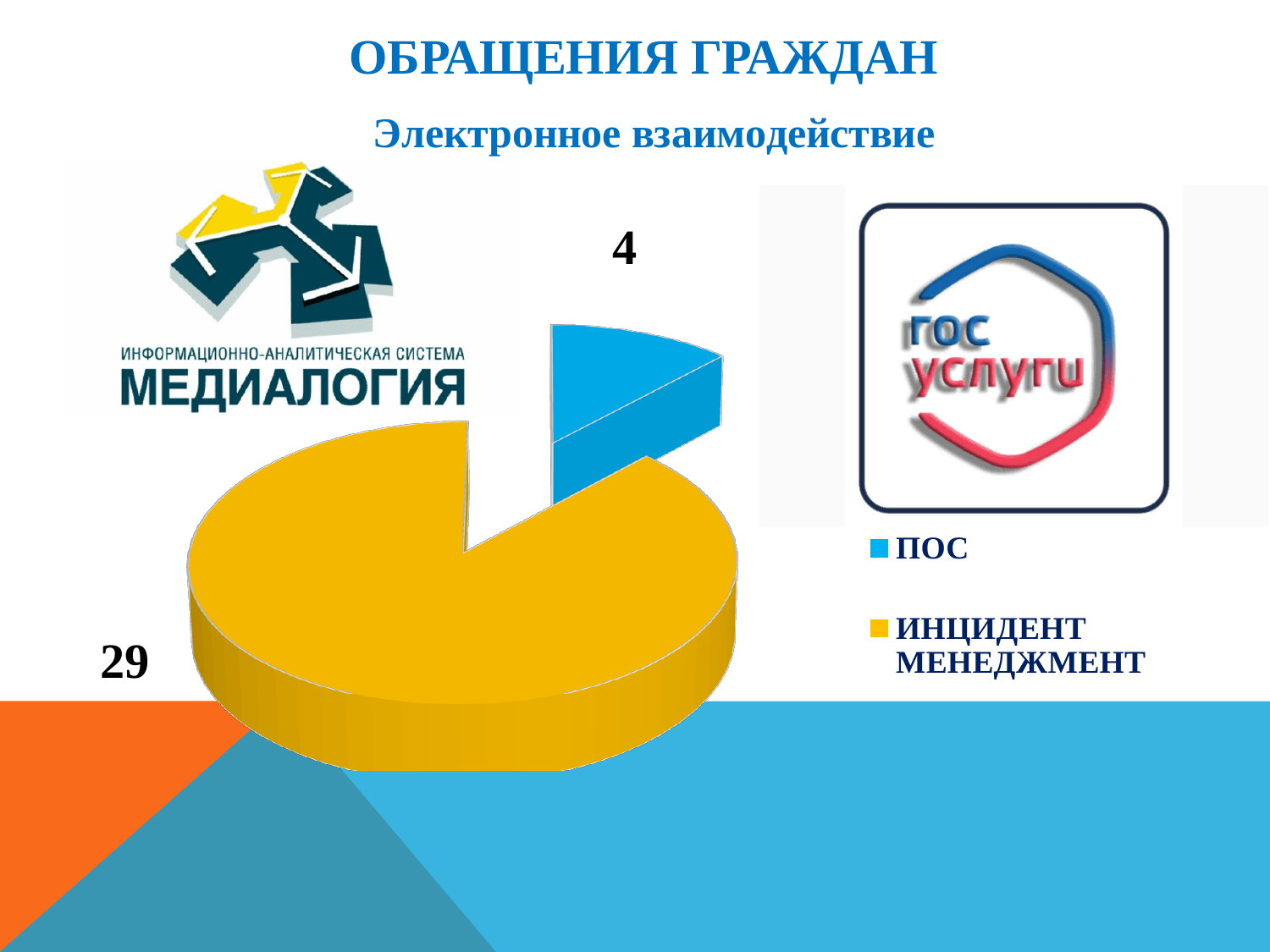
How many entries does the chart legend list? 2 What kind of chart is shown on the slide? pie chart What is the main title at the top of the slide? ОБРАЩЕНИЯ ГРАЖДАН Which is larger, the value for ПОС or the value for ИНЦИДЕНТ МЕНЕДЖМЕНТ? ИНЦИДЕНТ МЕНЕДЖМЕНТ Which category has the smallest slice in the pie chart? ПОС How many slices does the pie chart have? 2 What is the total of the two values shown in the pie chart? 33 What colour is the ПОС slice in the pie chart? blue What value is shown for the ПОС slice of the pie chart? 4 Which category has the largest slice in the pie chart? ИНЦИДЕНТ МЕНЕДЖМЕНТ What is the difference between the ИНЦИДЕНТ МЕНЕДЖМЕНТ value and the ПОС value? 25 What value is shown for the ИНЦИДЕНТ МЕНЕДЖМЕНТ slice of the pie chart? 29